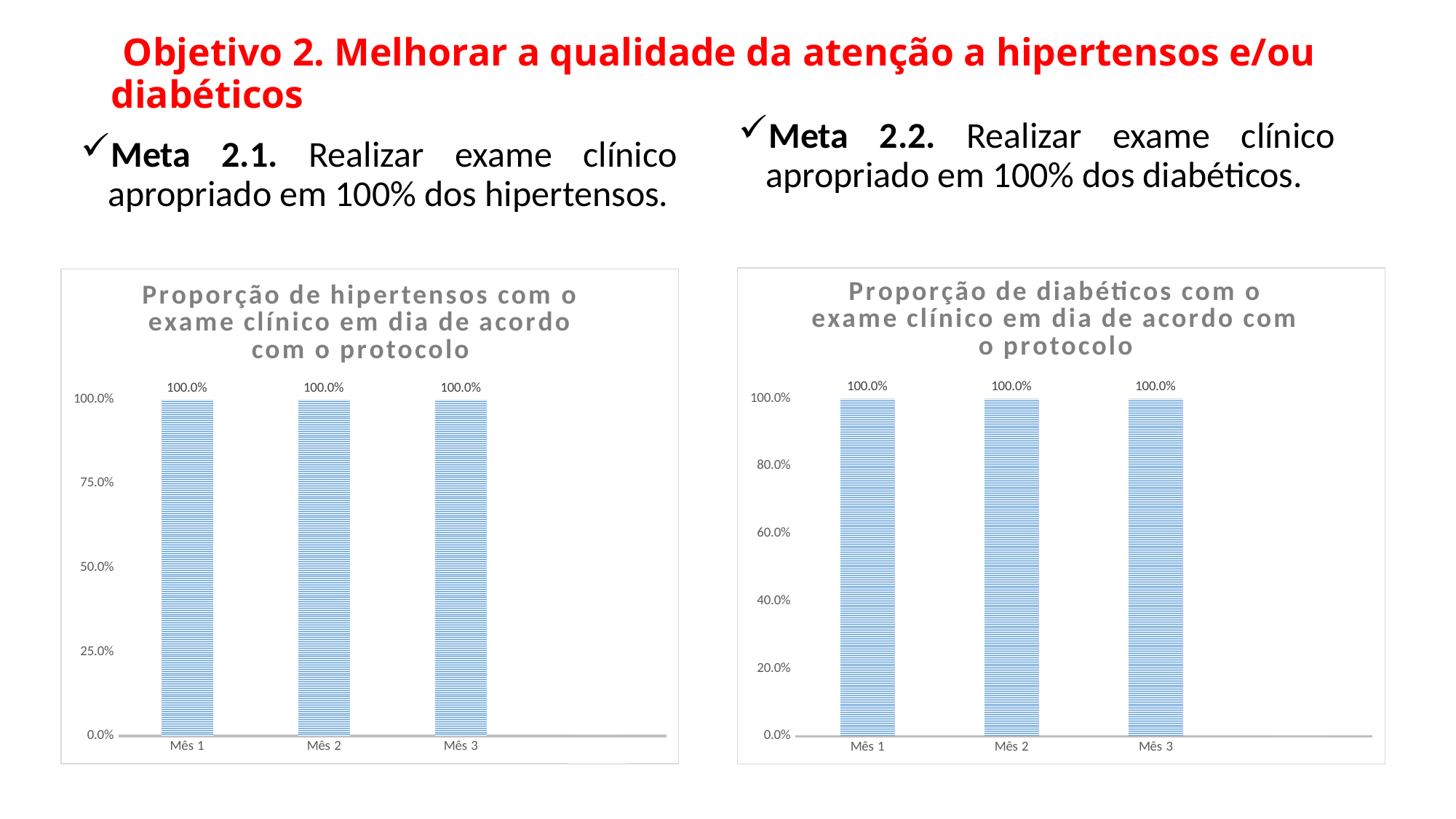
In the left chart (Proporção de hipertensos com o exame clínico em dia de acordo com o protocolo), what is the value for Mês 1? 100.0% In the right chart (Proporção de diabéticos com o exame clínico em dia de acordo com o protocolo), do the values rise, fall or stay the same from Mês 1 to Mês 3? Stay the same How many categories are shown on the x axis of the left chart (Proporção de hipertensos com o exame clínico em dia de acordo com o protocolo)? 3 In the right chart (Proporção de diabéticos com o exame clínico em dia de acordo com o protocolo), what is the difference between the values for Mês 3 and Mês 1? 0.0% In the left chart (Proporção de hipertensos com o exame clínico em dia de acordo com o protocolo), what is the difference between the values for Mês 1 and Mês 2? 0.0% What is the title of the right chart on the slide? Proporção de diabéticos com o exame clínico em dia de acordo com o protocolo How many bars are plotted in the right chart (Proporção de diabéticos com o exame clínico em dia de acordo com o protocolo)? 3 What kind of chart is the left chart (Proporção de hipertensos com o exame clínico em dia de acordo com o protocolo)? Bar chart In the right chart (Proporção de diabéticos com o exame clínico em dia de acordo com o protocolo), what is the value for Mês 3? 100.0% In the left chart (Proporção de hipertensos com o exame clínico em dia de acordo com o protocolo), what is the value for Mês 3? 100.0% In the left chart (Proporção de hipertensos com o exame clínico em dia de acordo com o protocolo), is the value for Mês 2 greater or less than 75.0%? greater In the right chart (Proporção de diabéticos com o exame clínico em dia de acordo com o protocolo), what is the value for Mês 2? 100.0%